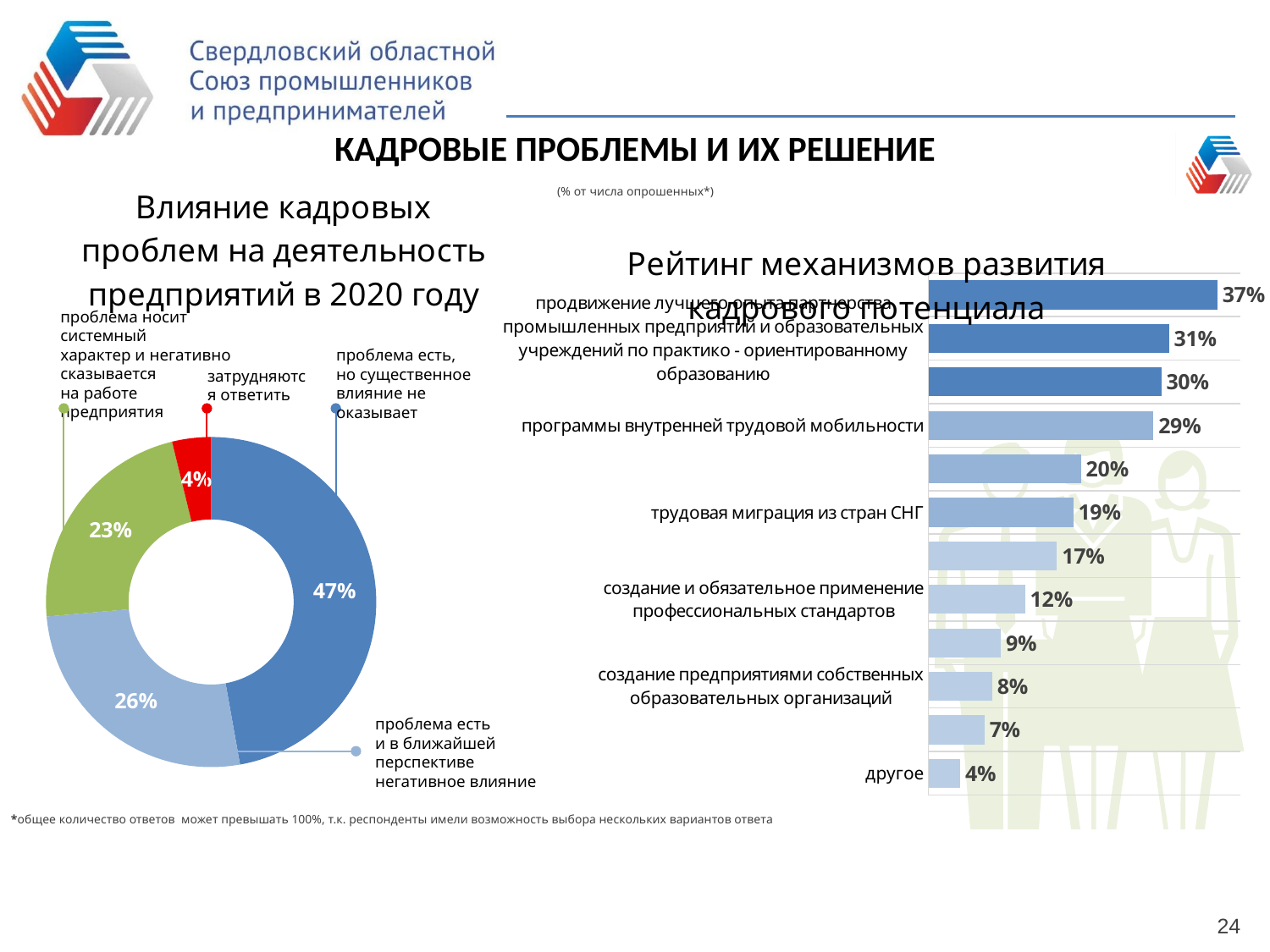
In the left pie chart, what is the difference between the 47% slice and the 26% slice? 21% In the left pie chart, which answer has the largest share? проблема есть, но существенное влияние не оказывает What kind of chart is the right chart titled 'Рейтинг механизмов развития кадрового потенциала'? bar chart In the right bar chart, how many bars are plotted? 12 In the left pie chart, what share of respondents answered 'затрудняются ответить'? 4% In the right bar chart, what is the value for 'программы внутренней трудовой мобильности'? 29% In the left pie chart, what share of respondents said the problem is systemic and negatively affects the enterprise ('проблема носит системный характер...')? 23% In the right bar chart, which category has the lowest value? другое In the left pie chart, what share of respondents answered 'проблема есть, но существенное влияние не оказывает'? 47% In the right bar chart, what is the value for 'создание предприятиями собственных образовательных организаций'? 8% In the right bar chart, what is the value for 'трудовая миграция из стран СНГ'? 19% What kind of chart is the left chart titled 'Влияние кадровых проблем на деятельность предприятий в 2020 году'? pie chart (donut)